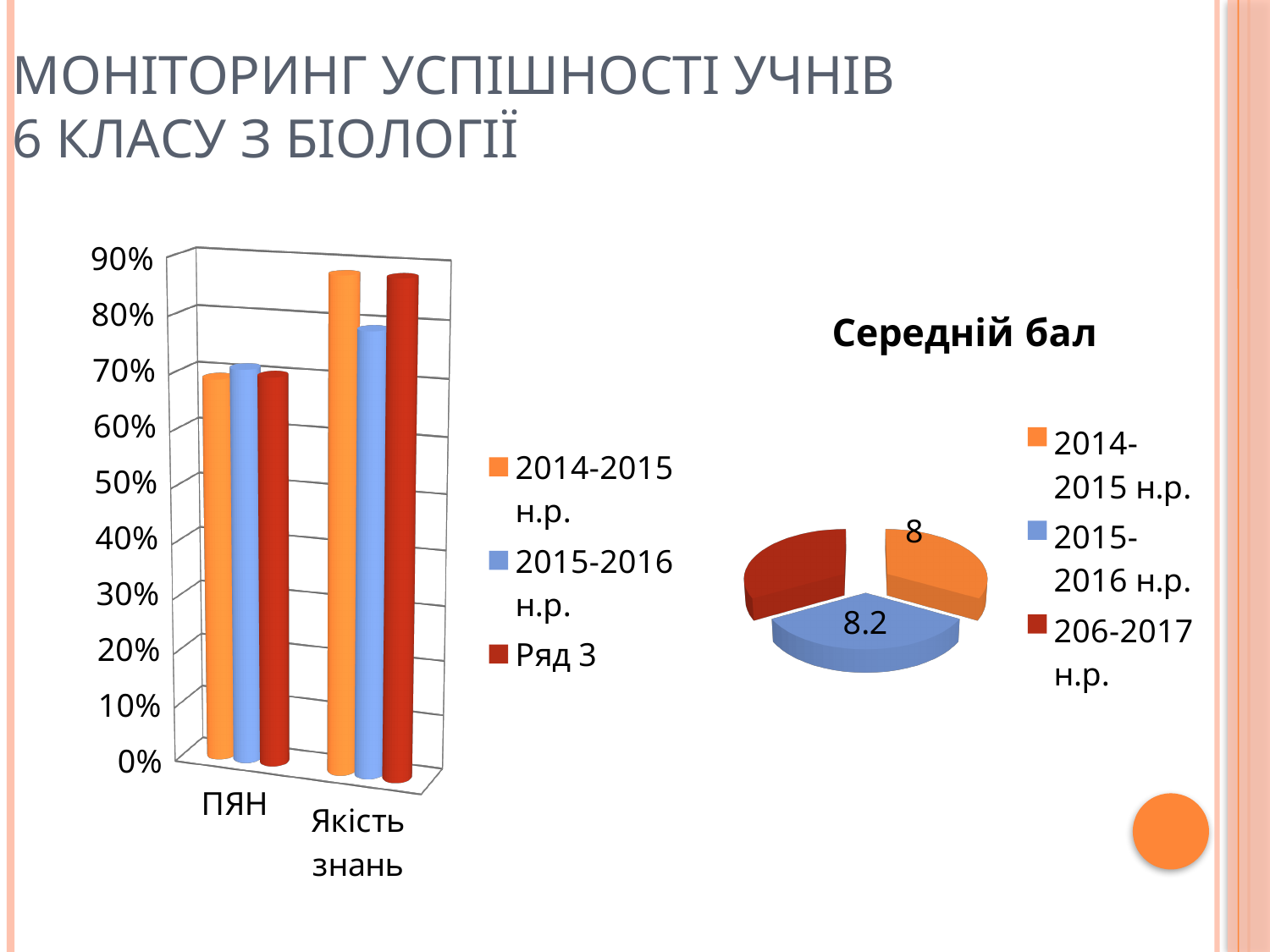
In the "Середній бал" pie chart, what is the value for 2014-2015 н.р.? 8 In the left bar chart, for Якість знань, which is larger: the 2014-2015 н.р. bar or the 2015-2016 н.р. bar? 2014-2015 н.р. In the left bar chart, is the value for Якість знань in 2014-2015 н.р. greater or less than 80%? greater How many series does the legend of the left bar chart list? 3 What kind of chart is the chart on the left of the slide? bar chart In the "Середній бал" pie chart, which is larger: the value for 2014-2015 н.р. or for 2015-2016 н.р.? 2015-2016 н.р. In the "Середній бал" pie chart, what is the value for 2015-2016 н.р.? 8.2 In the left bar chart, is the value for ПЯН in 2014-2015 н.р. greater or less than 60%? greater In the left bar chart, do the 2015-2016 н.р. values rise or fall from ПЯН to Якість знань? rise In the "Середній бал" pie chart, what is the difference between the values for 2015-2016 н.р. and 2014-2015 н.р.? 0.2 What kind of chart is the chart titled "Середній бал"? pie chart How many categories are shown on the x axis of the left bar chart? 2